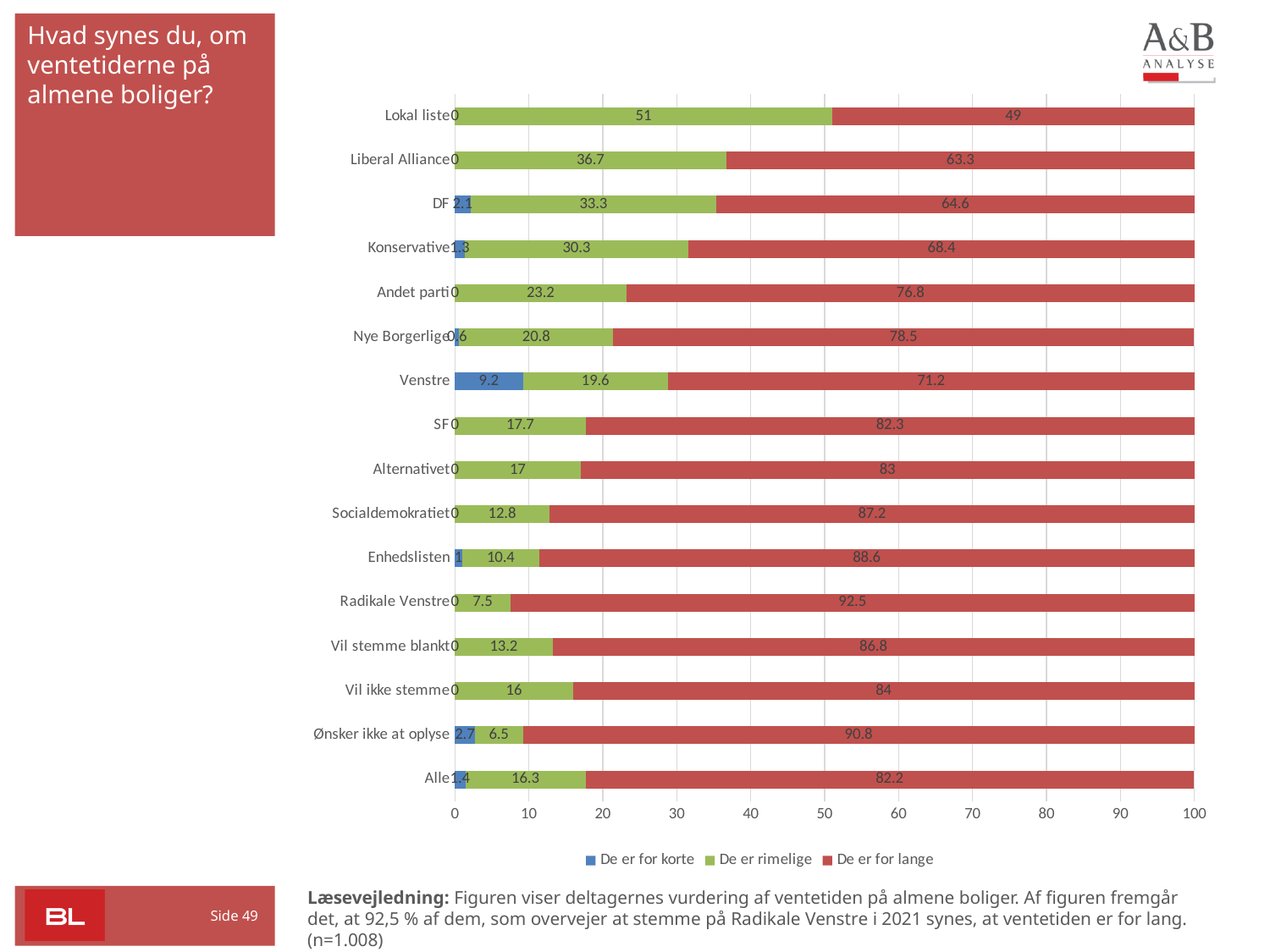
What is the value of 'De er for lange' for Radikale Venstre? 92.5 What is the value of 'De er rimelige' for Liberal Alliance? 36.7 What is the difference between the 'De er for lange' values for Socialdemokratiet and SF? 4.9 Which is larger, the 'De er rimelige' value for DF or for Konservative? DF Which category has the highest value for 'De er for lange'? Radikale Venstre Which series is shown in red in the chart? De er for lange How many categories are shown on the y axis of the chart? 16 How many series does the legend list? 3 What kind of chart is shown on the slide? stacked bar chart Is the 'De er for lange' value for Venstre greater or less than 70? greater Which category has the lowest value for 'De er for lange'? Lokal liste What is the value of 'De er for korte' for Venstre? 9.2